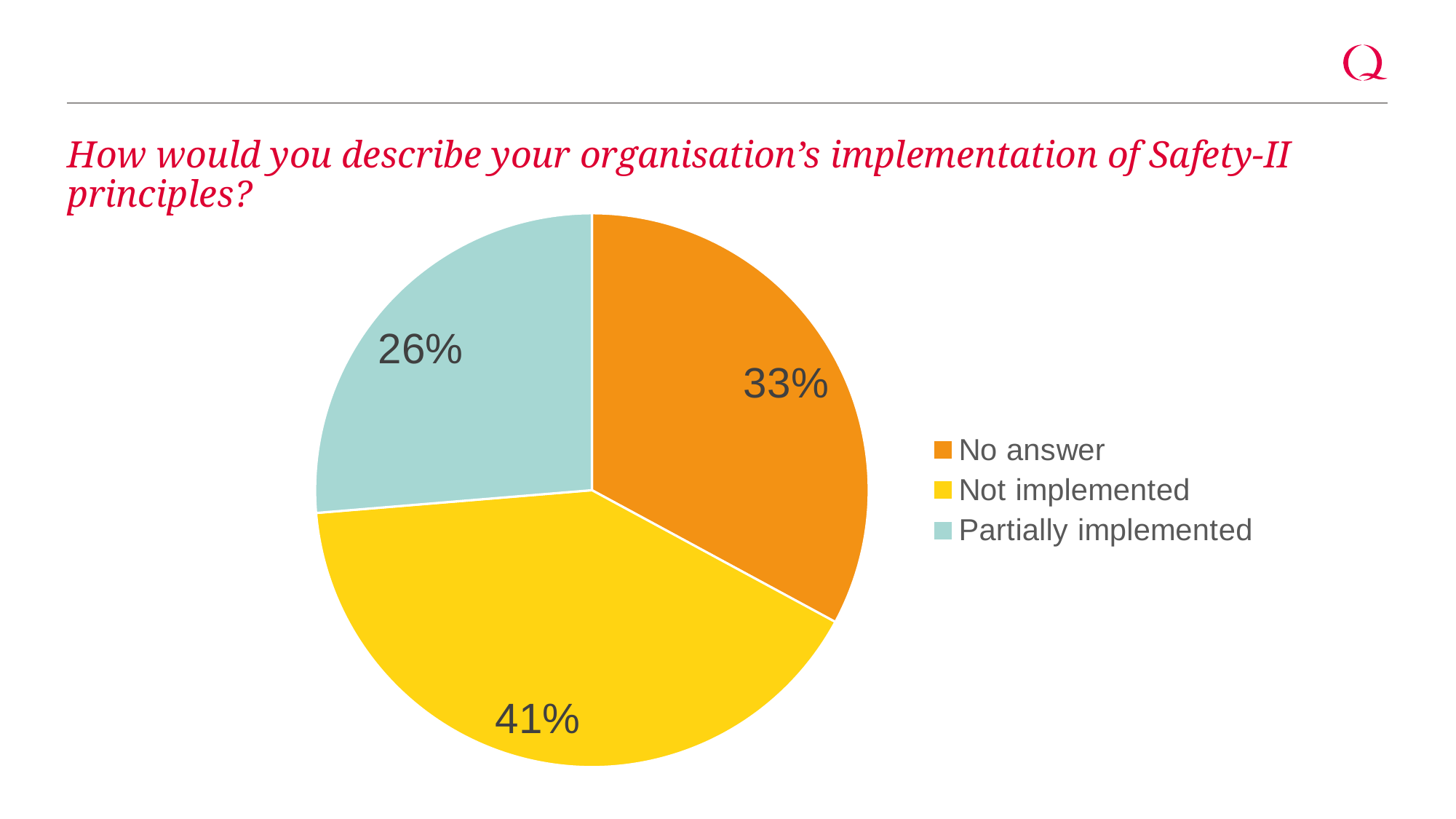
What percentage of respondents gave no answer? 33% What percentage of respondents said Safety-II principles were not implemented? 41% How many categories does the pie chart show? 3 What percentage of respondents said Safety-II principles were partially implemented? 26% What is the difference in percentage points between 'No answer' and 'Partially implemented'? 7 Which is larger: the share for 'No answer' or the share for 'Not implemented'? Not implemented What question does the chart title ask? How would you describe your organisation's implementation of Safety-II principles? What is the difference in percentage points between 'Not implemented' and 'Partially implemented'? 15 Which response category has the largest share of the pie? Not implemented What kind of chart is shown on the slide? Pie chart Which response category has the smallest share of the pie? Partially implemented What colour is the 'Partially implemented' slice? Light blue